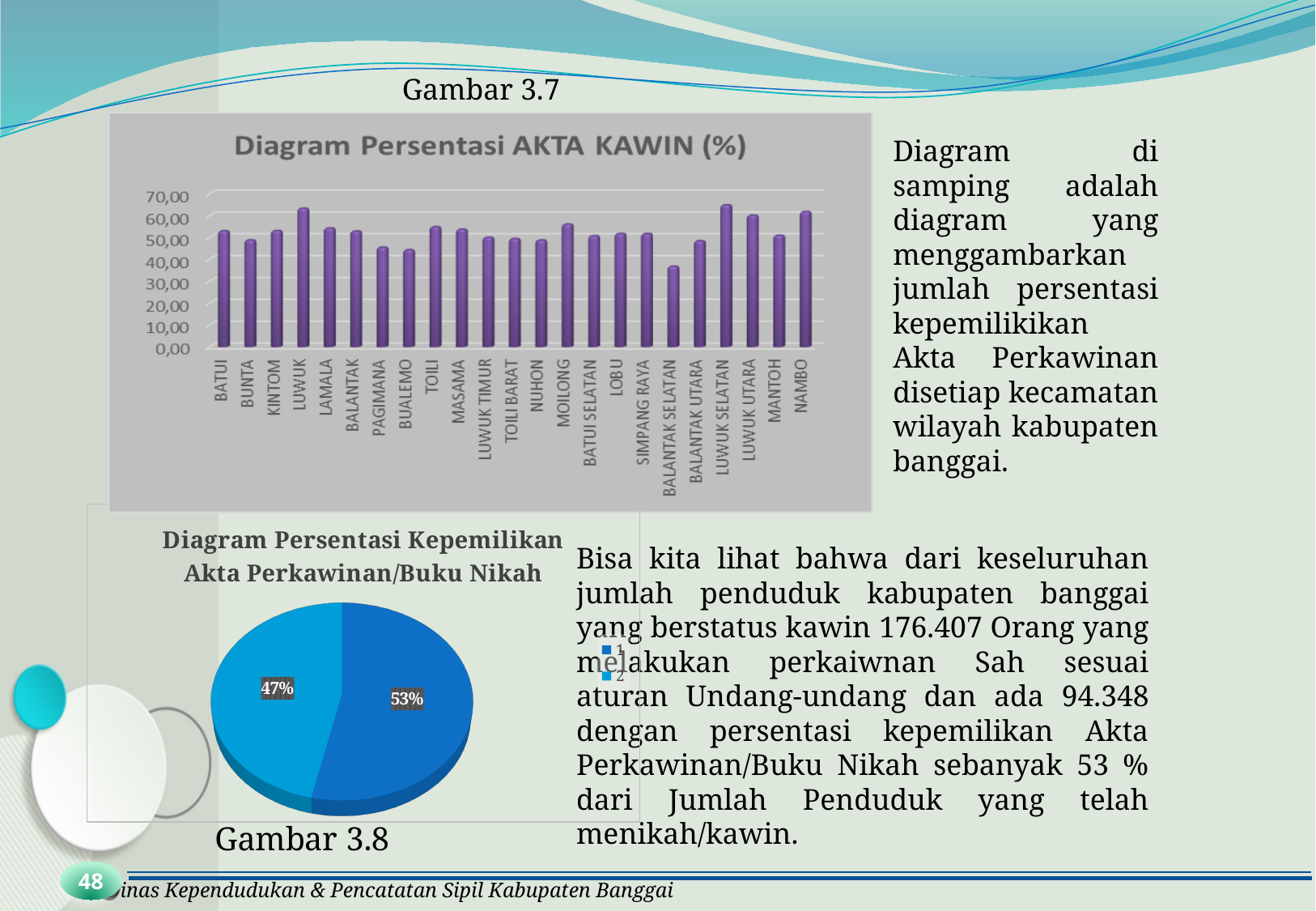
In the 'Diagram Persentasi AKTA KAWIN (%)' chart, is the value for LUWUK SELATAN greater or less than 60,00? greater In the 'Diagram Persentasi AKTA KAWIN (%)' chart, how many kecamatan categories are shown on the x axis? 23 In the 'Diagram Persentasi AKTA KAWIN (%)' chart, which kecamatan has the lowest value? BALANTAK SELATAN In the 'Diagram Persentasi AKTA KAWIN (%)' chart, is the value for BUALEMO greater or less than 50,00? less What type of chart is the 'Diagram Persentasi AKTA KAWIN (%)' chart? bar chart In the 'Diagram Persentasi Kepemilikan Akta Perkawinan/Buku Nikah' pie chart, what is the difference between the two slices' percentages? 6% In the 'Diagram Persentasi AKTA KAWIN (%)' chart, which is larger, the value for MOILONG or the value for BALANTAK SELATAN? MOILONG What type of chart is the 'Diagram Persentasi Kepemilikan Akta Perkawinan/Buku Nikah' chart? pie chart In the 'Diagram Persentasi AKTA KAWIN (%)' chart, is the value for LUWUK greater or less than 60,00? greater In the 'Diagram Persentasi Kepemilikan Akta Perkawinan/Buku Nikah' pie chart, what percentage is shown on the larger slice? 53% In the 'Diagram Persentasi AKTA KAWIN (%)' chart, which is larger, the value for LUWUK or the value for BUNTA? LUWUK